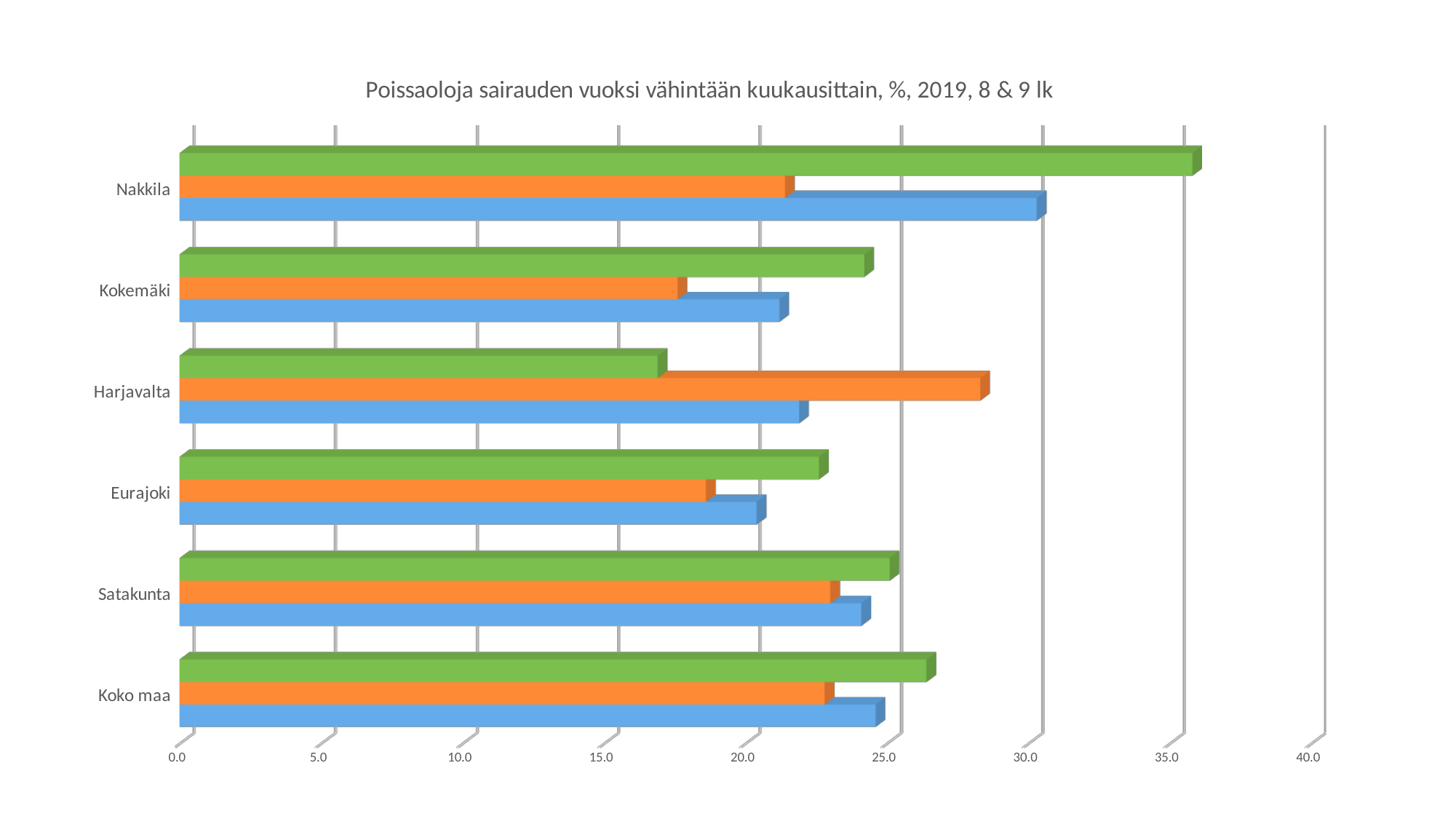
Which category has the longest orange bar? Harjavalta How many categories are shown on the vertical axis of the chart? 6 What is the title of the chart? Poissaoloja sairauden vuoksi vähintään kuukausittain, %, 2019, 8 & 9 lk Is the value of the orange bar for Harjavalta greater or less than 25? greater How many bars are plotted for each category in the chart? 3 Is the value of the green bar for Harjavalta greater or less than 20? less What kind of chart is shown on the slide? bar chart Which category has the longest blue bar? Nakkila For Nakkila, which is larger: the green bar or the orange bar? the green bar Which category has the shortest green bar? Harjavalta Which category has the longest green bar? Nakkila Is the value of the green bar for Nakkila greater or less than 35? greater